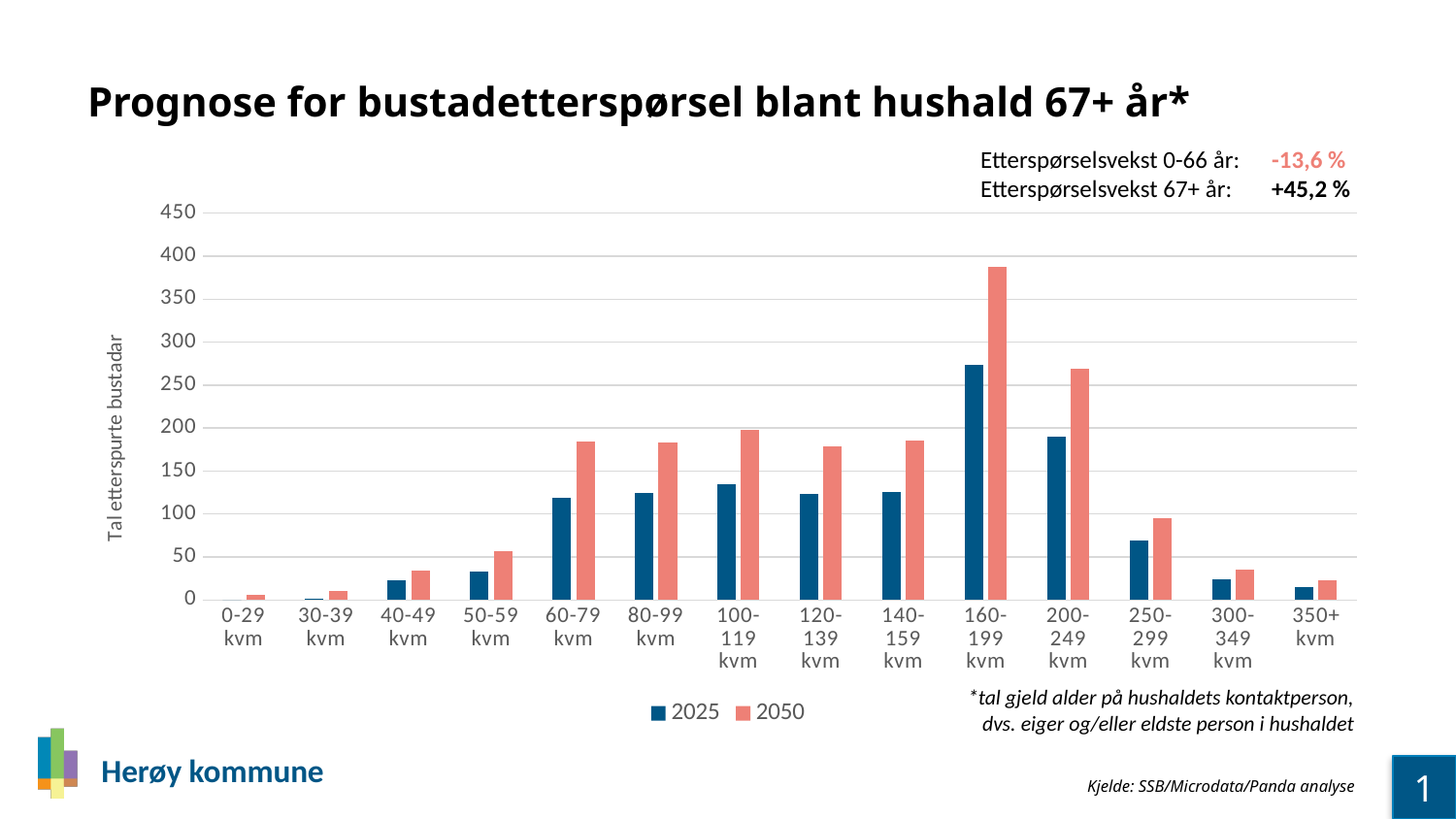
Is the 2025 value for 200-249 kvm greater or less than 200? less Is the 2025 value for 160-199 kvm greater or less than 250? greater Is the 2050 value for 60-79 kvm greater or less than 150? greater For the 160-199 kvm category, which series has the larger value, 2025 or 2050? 2050 Which size category has the highest value for the 2025 series? 160-199 kvm How many size categories are shown on the x axis? 14 Which size category has the highest value for the 2050 series? 160-199 kvm How many series does the legend list? 2 What kind of chart is shown on the slide? bar chart What is the label on the vertical axis? Tal etterspurte bustadar